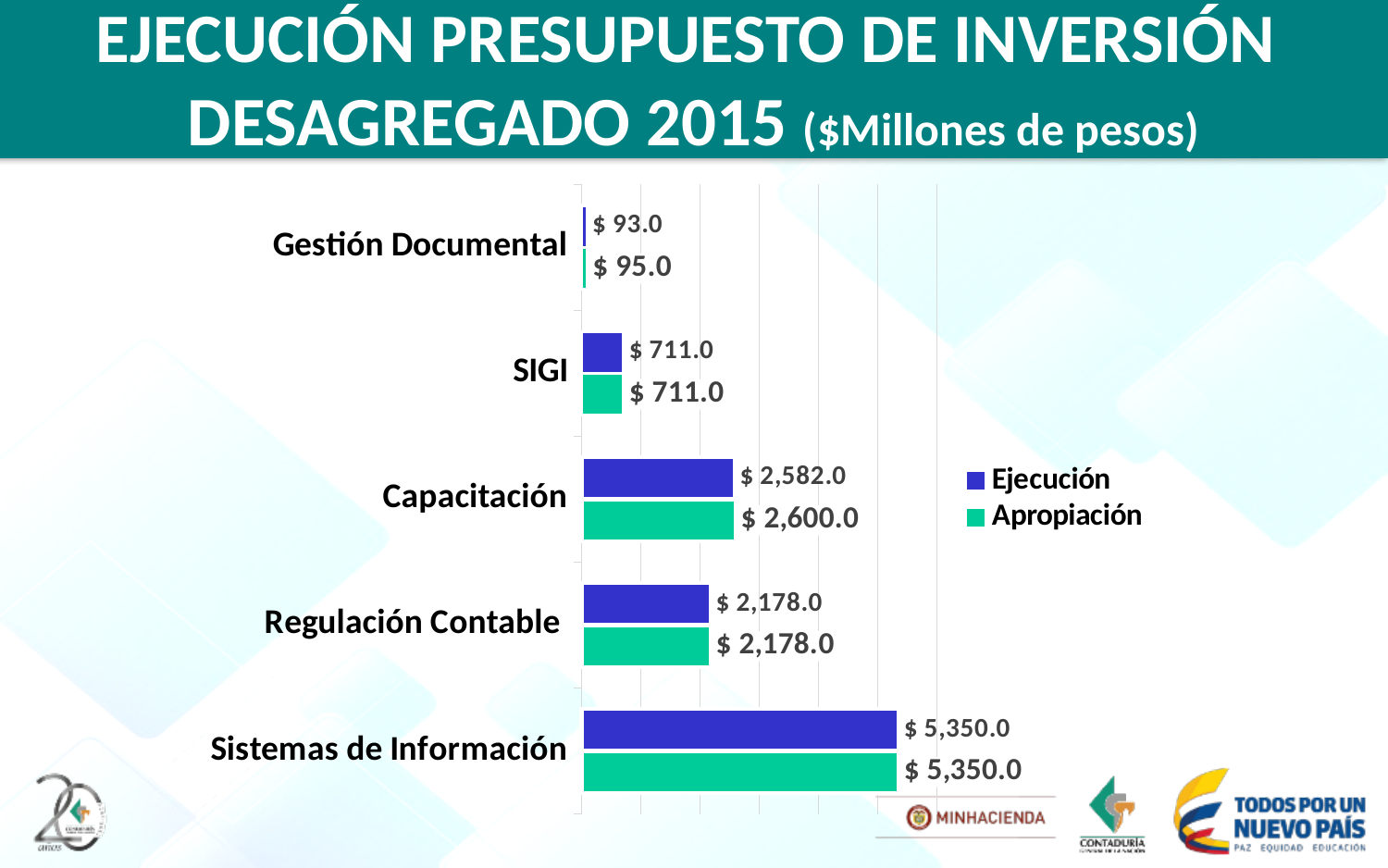
How many categories are shown on the chart? 5 What kind of chart is shown on the slide? Bar chart How many series does the legend list? 2 Which is larger, the Ejecución value for SIGI or the Ejecución value for Regulación Contable? Regulación Contable Which category has the lowest Apropiación value? Gestión Documental What is the Ejecución value for Sistemas de Información? $ 5,350.0 Which category has the highest Ejecución value? Sistemas de Información What is the Apropiación value for Gestión Documental? $ 95.0 What is the difference between the Apropiación and Ejecución values for Capacitación? $ 18.0 What is the Ejecución value for Capacitación? $ 2,582.0 What is the Apropiación value for Regulación Contable? $ 2,178.0 What is the difference between the Ejecución values for Capacitación and Regulación Contable? $ 404.0